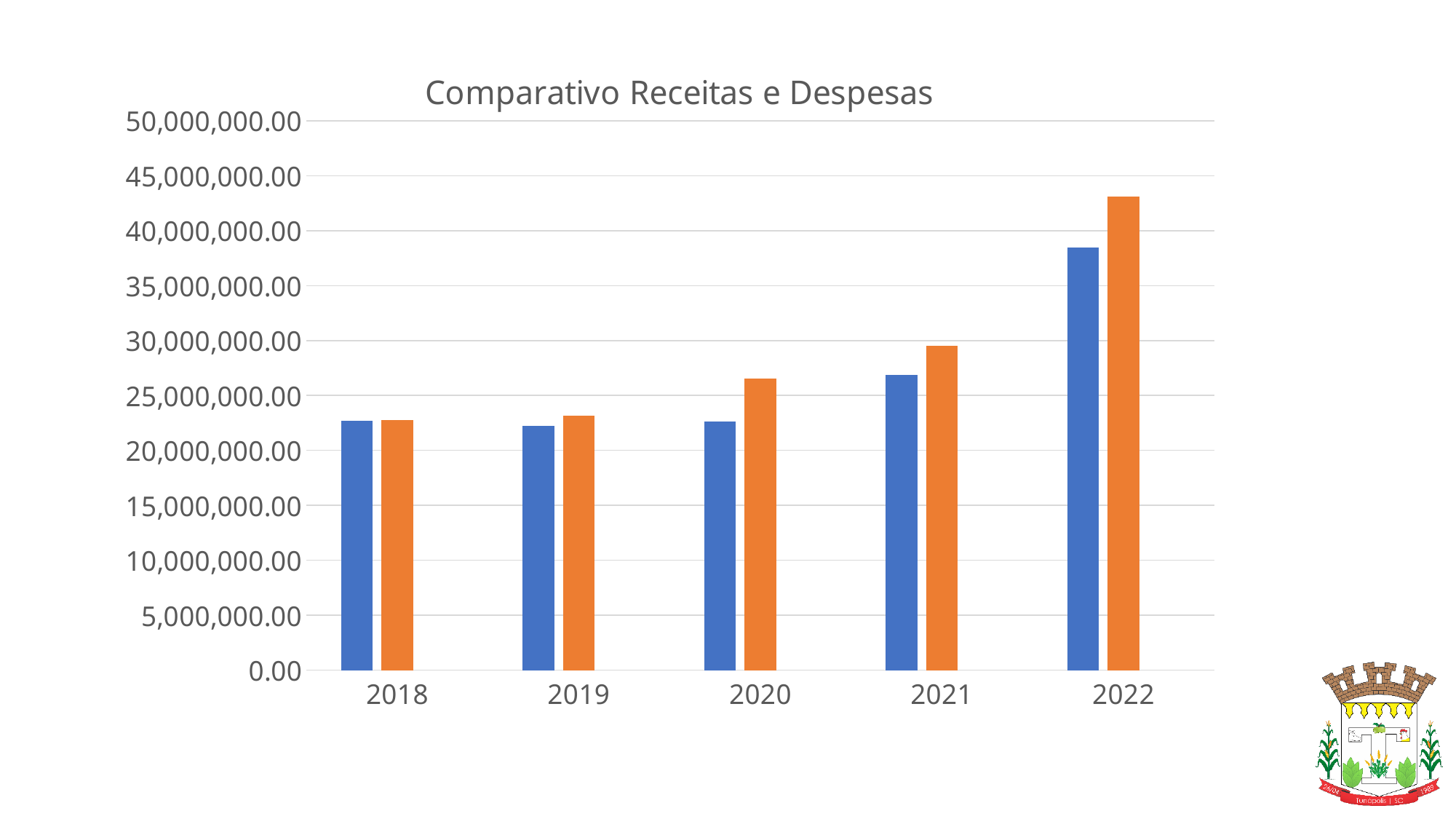
In which year is the blue bar the highest? 2022 Do the orange bars rise or fall from 2018 to 2022? rise Is the value of the orange bar for 2022 greater or less than 40,000,000.00? greater What is the title of the chart? Comparativo Receitas e Despesas How many years are shown on the x axis of the chart? 5 What kind of chart is shown on the slide? bar chart In which year is the orange bar the highest? 2022 Is the value of the orange bar for 2020 greater or less than 25,000,000.00? greater How many bars are plotted for each year in the chart? 2 For 2022, which bar is larger, the blue bar or the orange bar? orange Is the value of the blue bar for 2022 greater or less than 40,000,000.00? less